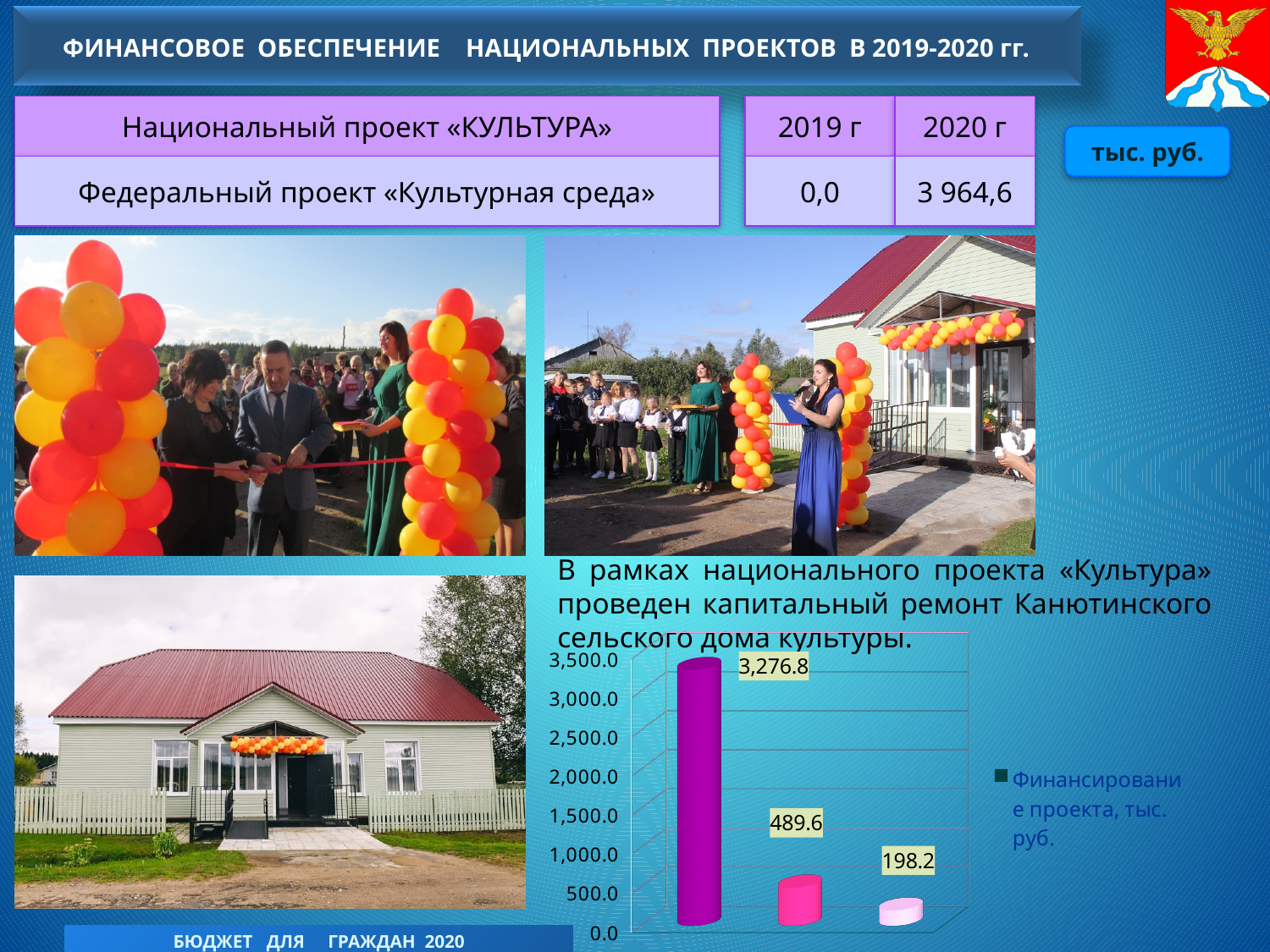
Do the bar values rise or fall from left to right in the chart? fall What is the difference between the leftmost bar (3,276.8) and the middle bar (489.6) in the chart? 2,787.2 Which is larger in the chart: the middle bar or the rightmost bar? the middle bar (489.6) How many bars does the chart at the bottom right of the slide show? 3 How many series does the legend of the chart list? 1 What is the legend entry of the chart? Финансирование проекта, тыс. руб. What is the value shown on the data label of the leftmost (tallest) bar in the chart? 3,276.8 What is the value shown on the data label of the rightmost bar in the chart? 198.2 What kind of chart is shown at the bottom right of the slide? bar chart What is the lowest value shown in the chart? 198.2 What is the highest value shown in the chart? 3,276.8 What is the value shown on the data label of the middle bar in the chart? 489.6